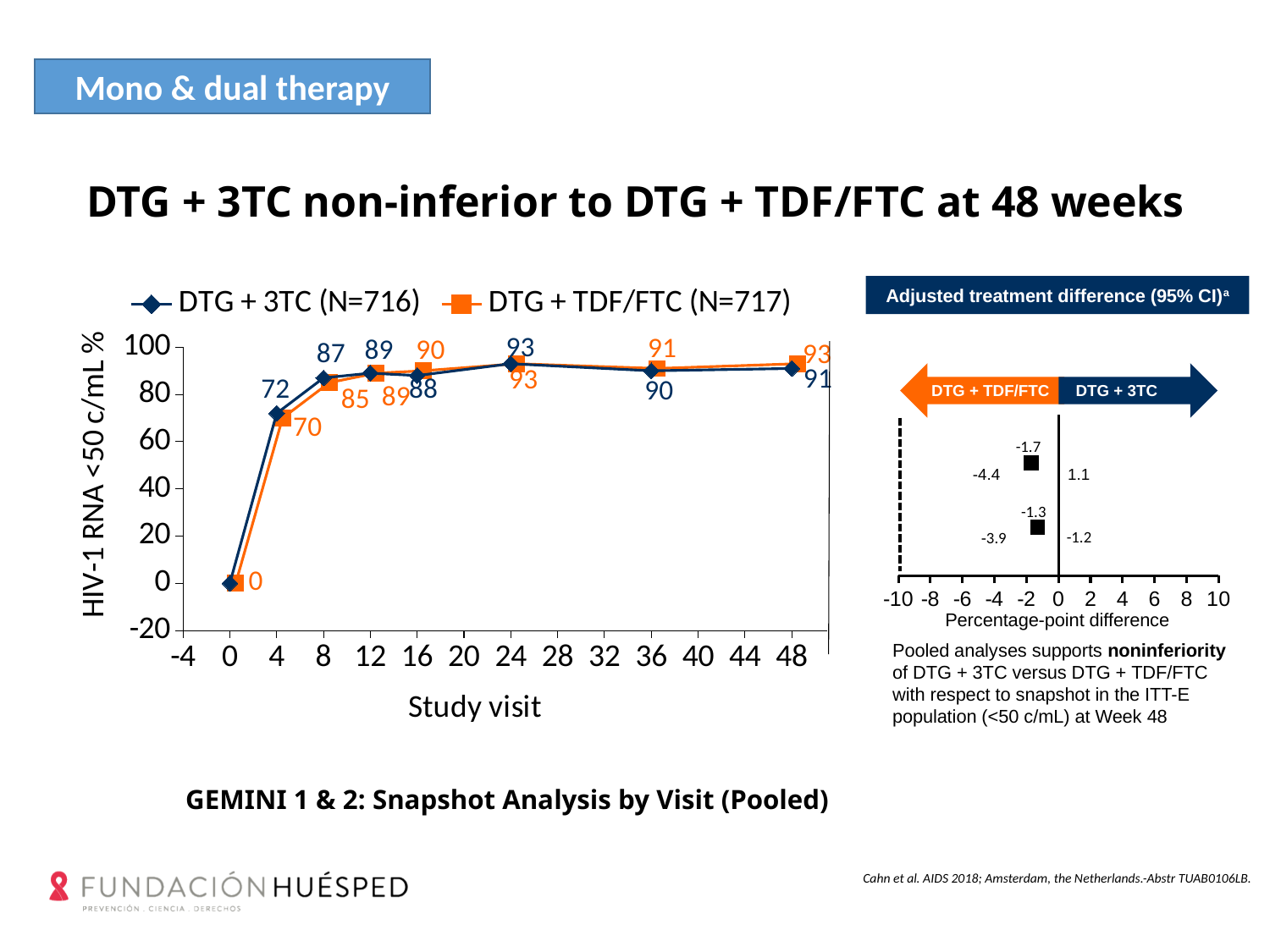
In the GEMINI 1 & 2 line chart, do the values for DTG + 3TC rise or fall between week 0 and week 8? Rise In the GEMINI 1 & 2 line chart, what is the value for DTG + 3TC at study visit week 4? 72 In the GEMINI 1 & 2 line chart, which series has the higher value at week 48, DTG + 3TC or DTG + TDF/FTC? DTG + TDF/FTC In the GEMINI 1 & 2 line chart, what is the value for DTG + TDF/FTC at week 8? 85 In the GEMINI 1 & 2 line chart, what is the value for DTG + TDF/FTC at week 48? 93 What kind of chart is the GEMINI 1 & 2 Snapshot Analysis by Visit chart? Line chart In the GEMINI 1 & 2 line chart, at which study visit does DTG + 3TC reach its highest value? 24 How many series does the legend of the GEMINI 1 & 2 line chart list? 2 In the GEMINI 1 & 2 line chart, what is the value for DTG + 3TC at week 48? 91 In the GEMINI 1 & 2 line chart, what is the value for DTG + TDF/FTC at study visit week 4? 70 In the GEMINI 1 & 2 line chart, what is the difference between DTG + 3TC and DTG + TDF/FTC at week 8? 2 In the Adjusted treatment difference chart on the right, what is the point estimate of the upper (first) treatment difference? -1.7